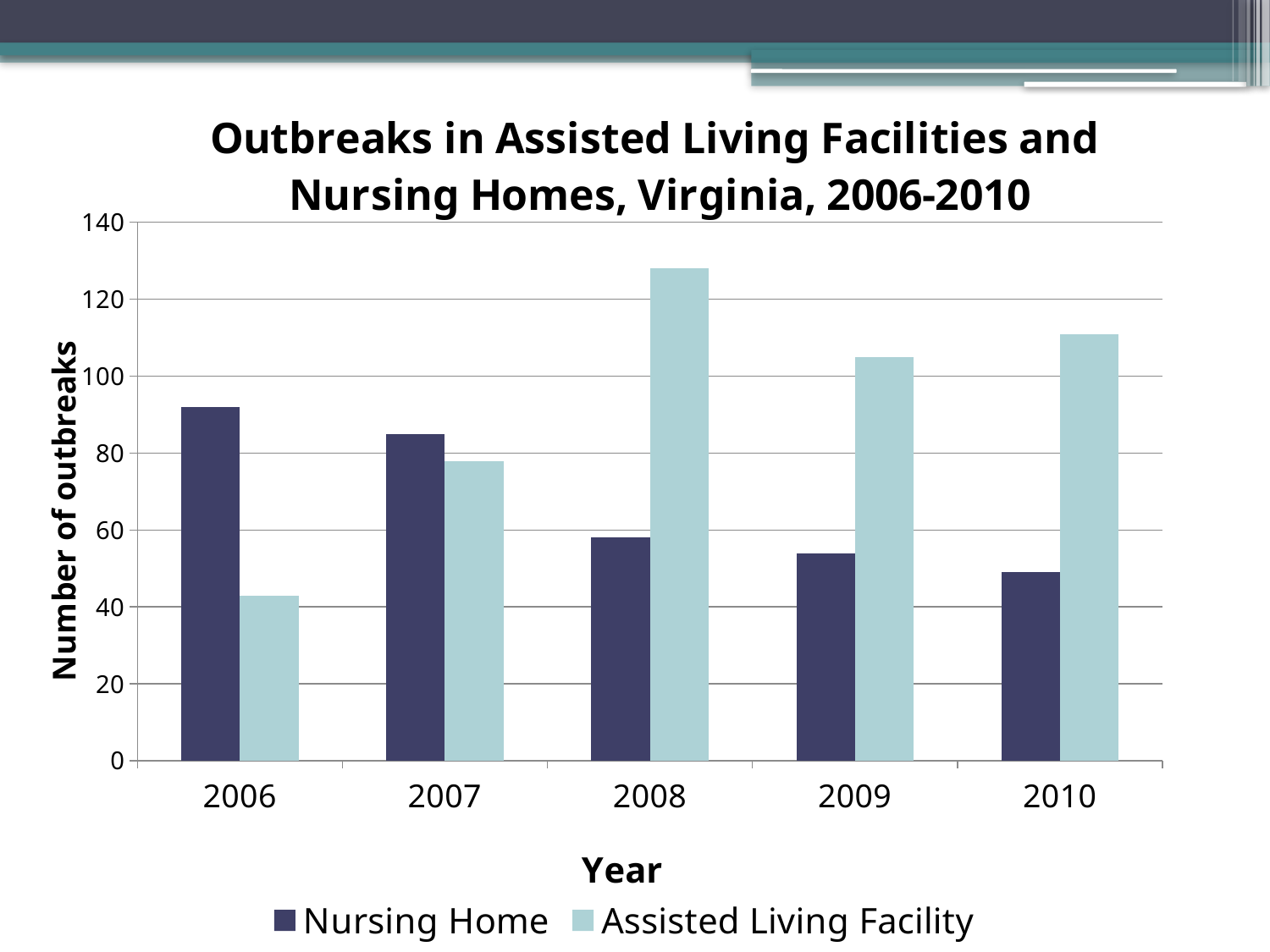
Is the Nursing Home value for 2010 greater or less than 60? less What is the label on the y axis? Number of outbreaks In which year is the Assisted Living Facility value highest? 2008 What kind of chart is shown on the slide? bar chart In 2006, which is larger: Nursing Home or Assisted Living Facility? Nursing Home In which year is the Nursing Home value lowest? 2010 Do the Nursing Home values rise or fall from 2006 to 2010? fall How many years are shown on the x axis? 5 Is the Nursing Home value for 2006 greater or less than 80? greater In which year is the Assisted Living Facility value lowest? 2006 Is the Assisted Living Facility value for 2008 greater or less than 120? greater How many series does the legend list? 2